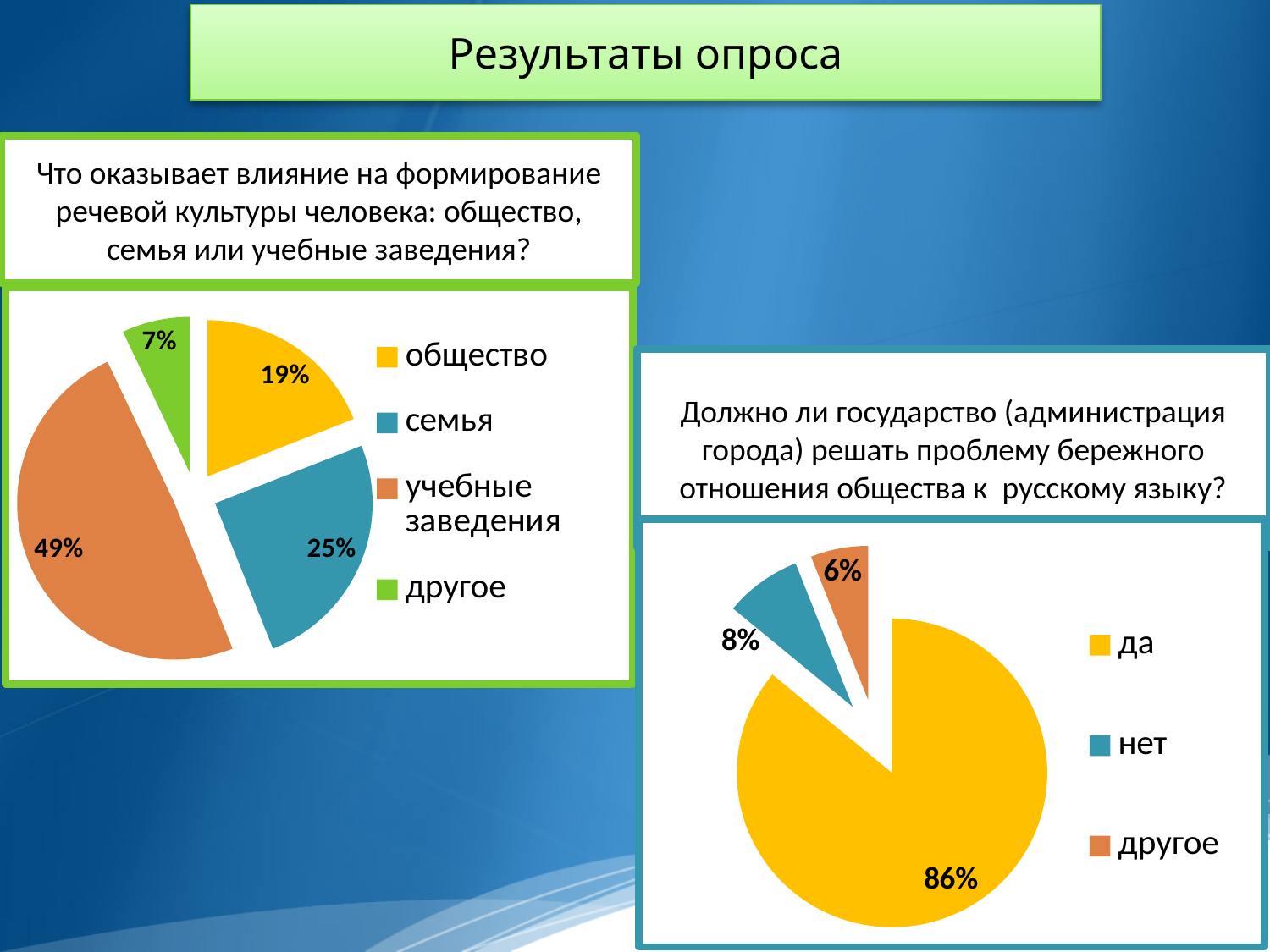
In the left pie chart (about what influences speech culture), what is the difference between the shares for семья and общество? 6% In the left pie chart (about what influences speech culture), how many categories does the legend list? 4 In the left pie chart (about what influences speech culture), which category has the smallest slice? другое In the left pie chart (about what influences speech culture), which category has the largest slice? учебные заведения What type of chart is used on the right side of the slide? pie chart In the left pie chart (about what influences speech culture), what share is labelled for семья? 25% In the right pie chart (about whether the state should address the problem), what share is labelled for да? 86% In the right pie chart (about whether the state should address the problem), what share is labelled for нет? 8% In the left pie chart (about what influences speech culture), what share is labelled for учебные заведения? 49% In the right pie chart (about whether the state should address the problem), which is larger, нет or другое? нет In the left pie chart (about what influences speech culture), what share is labelled for общество? 19% In the right pie chart (about whether the state should address the problem), what is the difference between the shares for да and нет? 78%